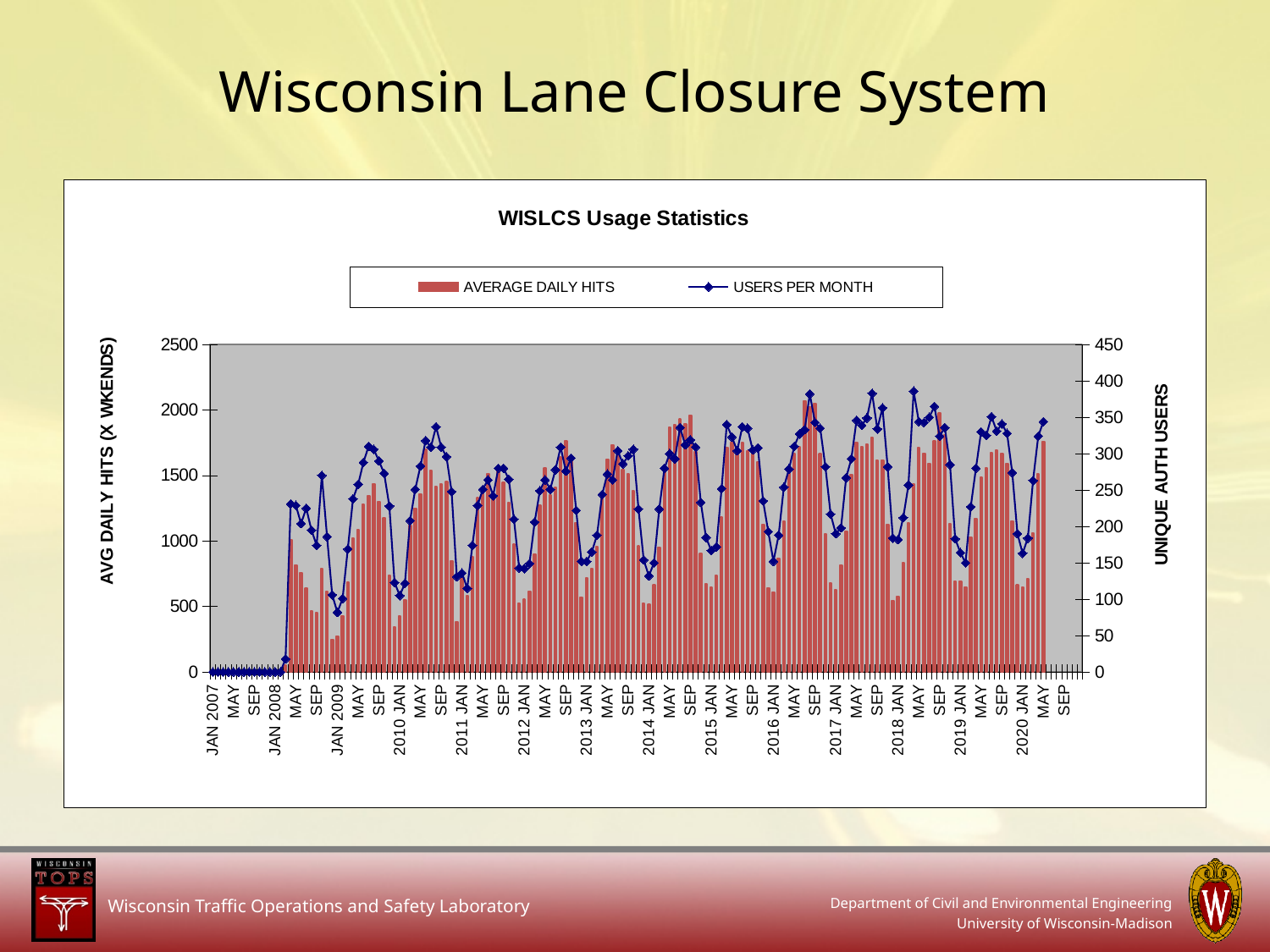
Which series is drawn as bars? AVERAGE DAILY HITS Is the value for USERS PER MONTH in JAN 2007 greater or less than 50? less Do the USERS PER MONTH values generally rise or fall from JAN 2008 to SEP 2010? rise Is the value for AVERAGE DAILY HITS in JAN 2007 greater or less than 500? less What is the maximum value shown on the right vertical axis? 450 How many series does the chart legend list? 2 What kind of chart is this? A combined bar and line chart Is the value for AVERAGE DAILY HITS in SEP 2016 greater or less than 1500? greater What is the label of the left vertical axis? AVG DAILY HITS (X WKENDS)